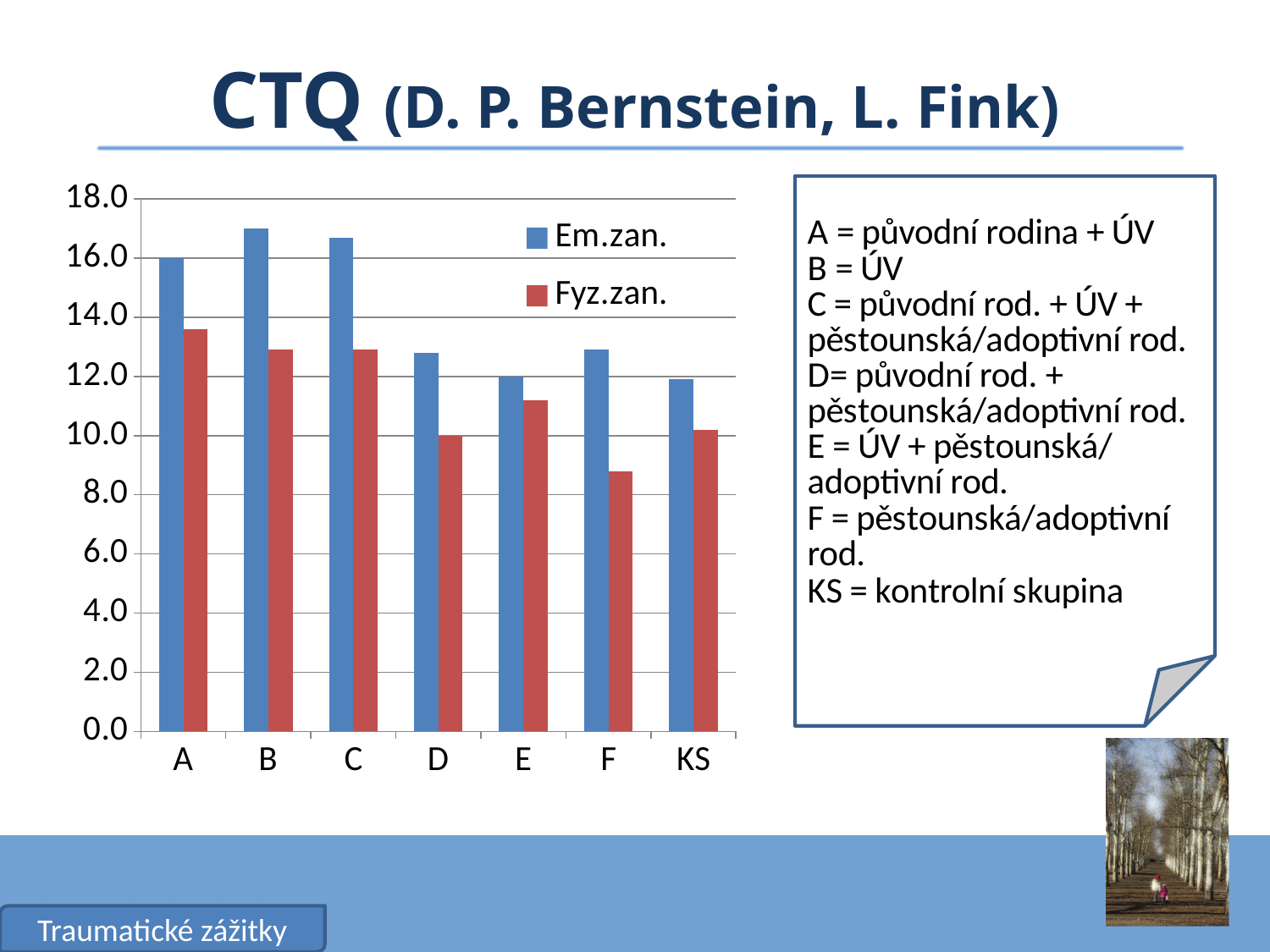
How many series does the chart legend list? 2 Is the Fyz.zan. value for F greater or less than 10.0? less Which category has the highest Em.zan. value? B What are the two series named in the chart legend? Em.zan. and Fyz.zan. Which category has the lowest Fyz.zan. value? F Is the Em.zan. value for D greater or less than 12.0? greater How many categories are shown on the x axis of the chart? 7 For category F, which is larger: Em.zan. or Fyz.zan.? Em.zan. What kind of chart is shown on the slide? bar chart Is the Em.zan. value for B greater or less than 16.0? greater Which category has the highest Fyz.zan. value? A